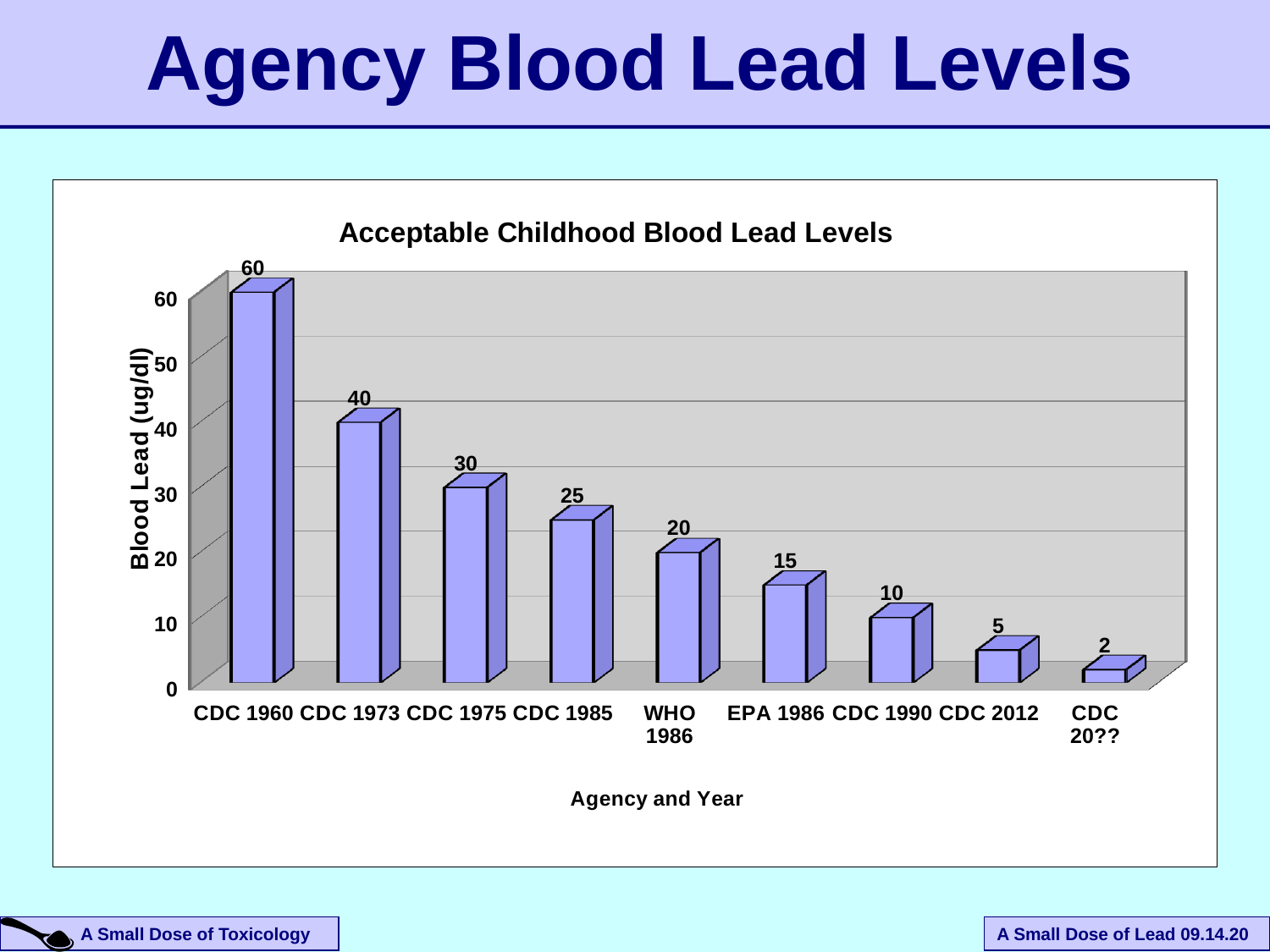
How many categories are shown on the x axis? 9 Do the values rise or fall from left to right along the x axis? fall What value is shown for CDC 2012? 5 What is the title of the chart? Acceptable Childhood Blood Lead Levels What value is shown for WHO 1986? 20 What kind of chart is this? bar chart Is the value for CDC 1975 greater or less than 20? greater Which category has the lowest blood lead level? CDC 20?? What is the acceptable childhood blood lead level shown for CDC 1960? 60 Which is larger, the value for EPA 1986 or the value for CDC 1990? EPA 1986 Which category has the highest blood lead level? CDC 1960 What is the difference between the values for CDC 1973 and CDC 1985? 15